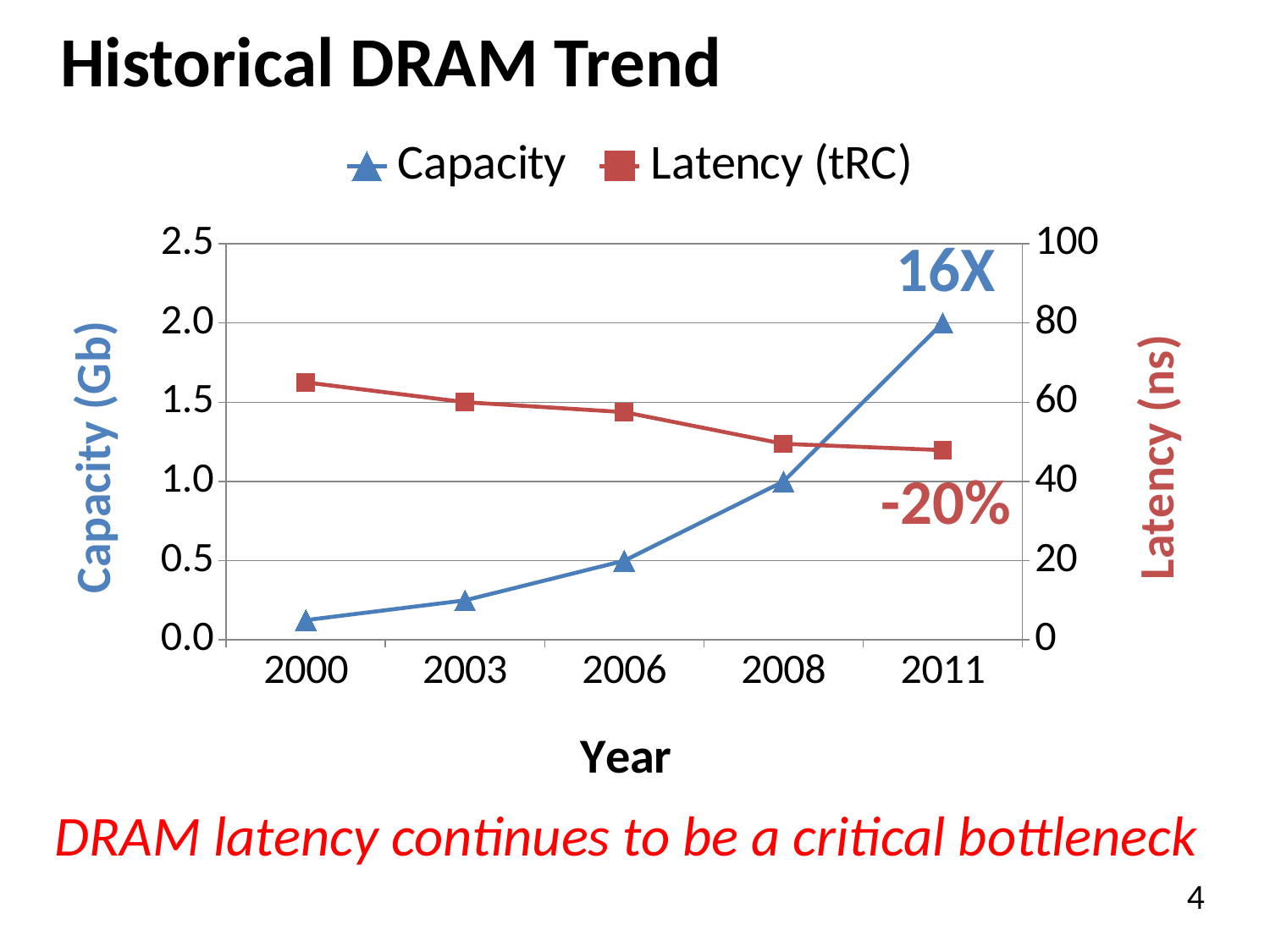
How many series does the legend list? 2 What annotation is printed next to the Capacity series at 2011? 16X How many years are plotted along the x axis? 5 In which year is Latency (tRC) highest? 2000 What kind of chart is shown on the slide? line chart What is the Capacity value in 2008? 1.0 In which year is Capacity highest? 2011 Is the Latency (tRC) value in 2000 greater or less than 60? greater What is the Capacity value in 2011? 2.0 Does the Capacity series rise or fall from 2000 to 2011? rise Is the Capacity value in 2000 greater or less than 0.5? less Does the Latency (tRC) series rise or fall from 2000 to 2011? fall